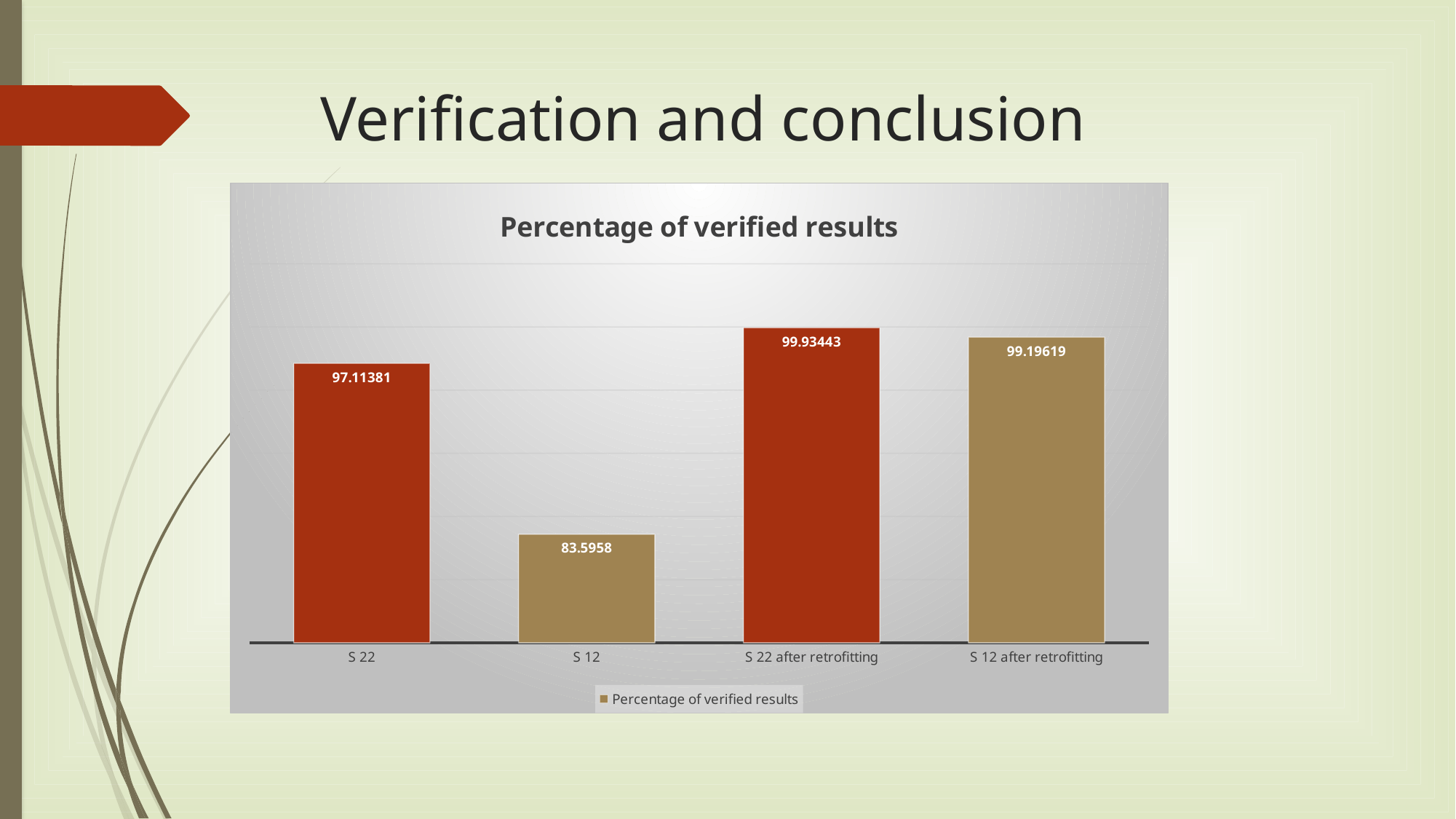
What is the value for S 12 after retrofitting? 99.19619 What is the value for S 22? 97.11381 Which category has the lowest value? S 12 What is the title of the chart? Percentage of verified results What type of chart is shown on the slide? bar chart Which category has the highest value? S 22 after retrofitting What is the value for S 12? 83.5958 What is the value for S 22 after retrofitting? 99.93443 How many series does the legend list? 1 How many categories are shown on the x axis? 4 Which is larger, the value for S 22 or the value for S 12? S 22 What is the difference between the value for S 12 after retrofitting and the value for S 12? 15.60039